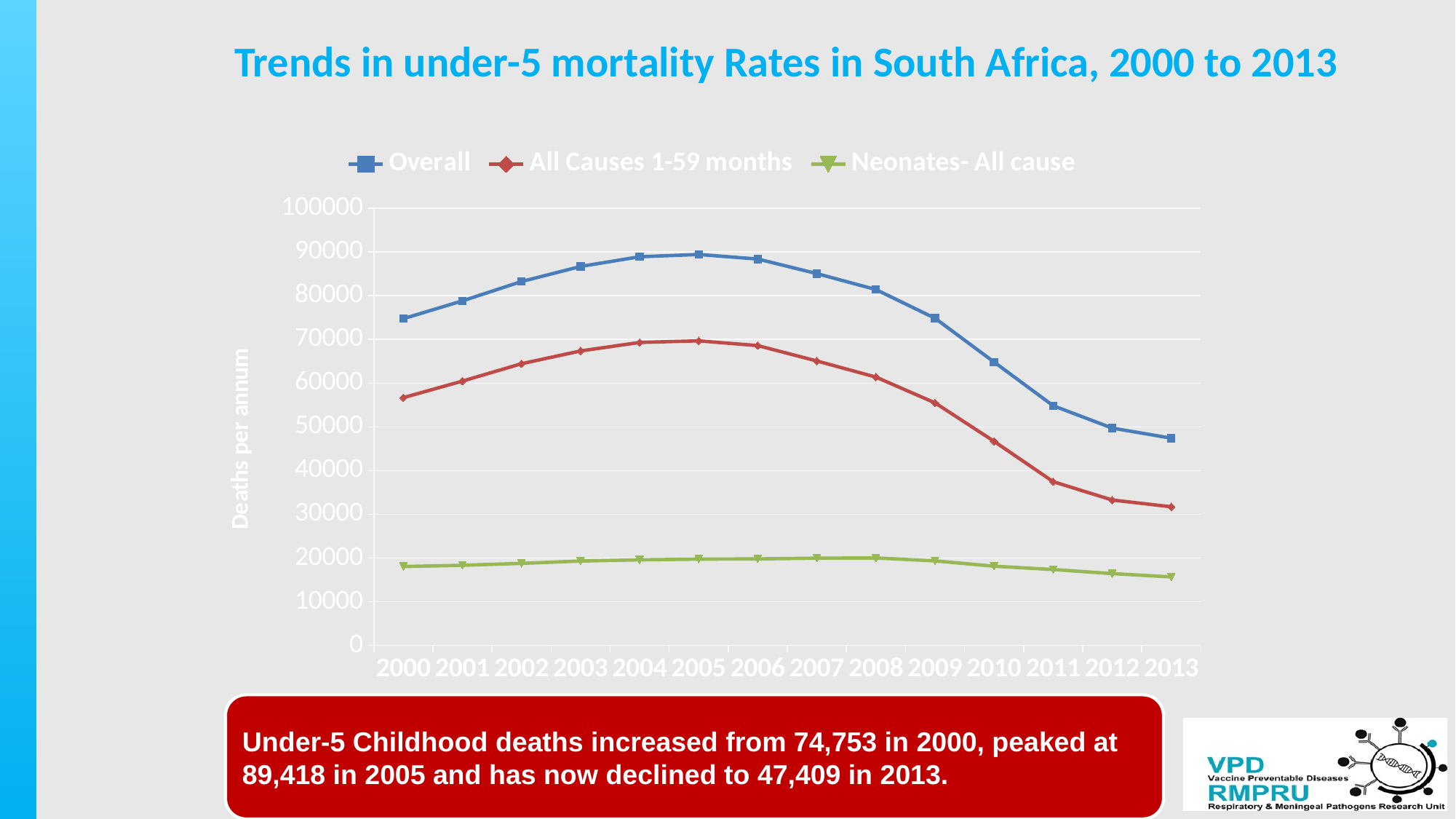
Is the value for All Causes 1-59 months in 2013 greater or less than 40000? less Which series has the lowest values across all years? Neonates- All cause According to the slide, what was the number of under-5 childhood deaths (Overall) in 2013? 47,409 What type of chart is shown on the slide? Line chart According to the slide, what was the peak number of under-5 childhood deaths (Overall) in 2005? 89,418 Is the value for Neonates- All cause in 2005 greater or less than 30000? less In which year does the Overall series reach its highest value? 2005 How many series does the legend list? 3 How many years are plotted along the x axis? 14 According to the slide, what was the number of under-5 childhood deaths (Overall) in 2000? 74,753 By how much did Overall under-5 deaths decline from the 2005 peak (89,418) to 2013 (47,409)? 42,009 Does the Overall series rise or fall between 2005 and 2013? Fall